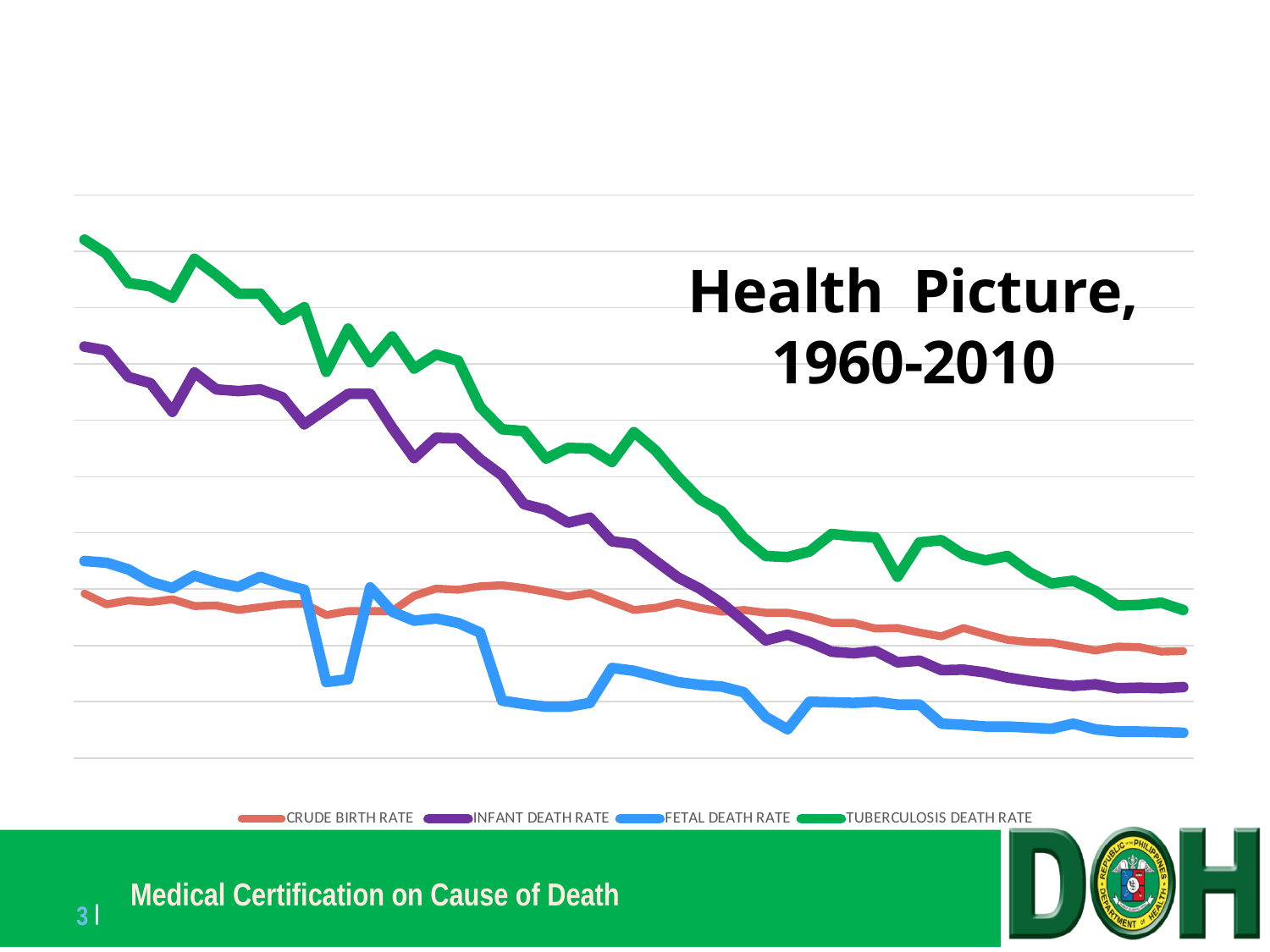
At the right (end) of the chart, which is higher: CRUDE BIRTH RATE or INFANT DEATH RATE? CRUDE BIRTH RATE Does the FETAL DEATH RATE line rise or fall overall from left to right? fall At the left (start) of the chart, which is higher: INFANT DEATH RATE or CRUDE BIRTH RATE? INFANT DEATH RATE Which series is drawn in green? TUBERCULOSIS DEATH RATE What kind of chart is shown on the slide? line chart At the right (end) of the chart, which is higher: TUBERCULOSIS DEATH RATE or FETAL DEATH RATE? TUBERCULOSIS DEATH RATE What is the title of the chart? Health Picture, 1960-2010 How many series does the chart's legend list? 4 Does the TUBERCULOSIS DEATH RATE line rise or fall from left to right? fall Does the INFANT DEATH RATE line rise or fall from left to right? fall Which series is highest at the left (start) of the chart? TUBERCULOSIS DEATH RATE Which series is lowest at the right (end) of the chart? FETAL DEATH RATE